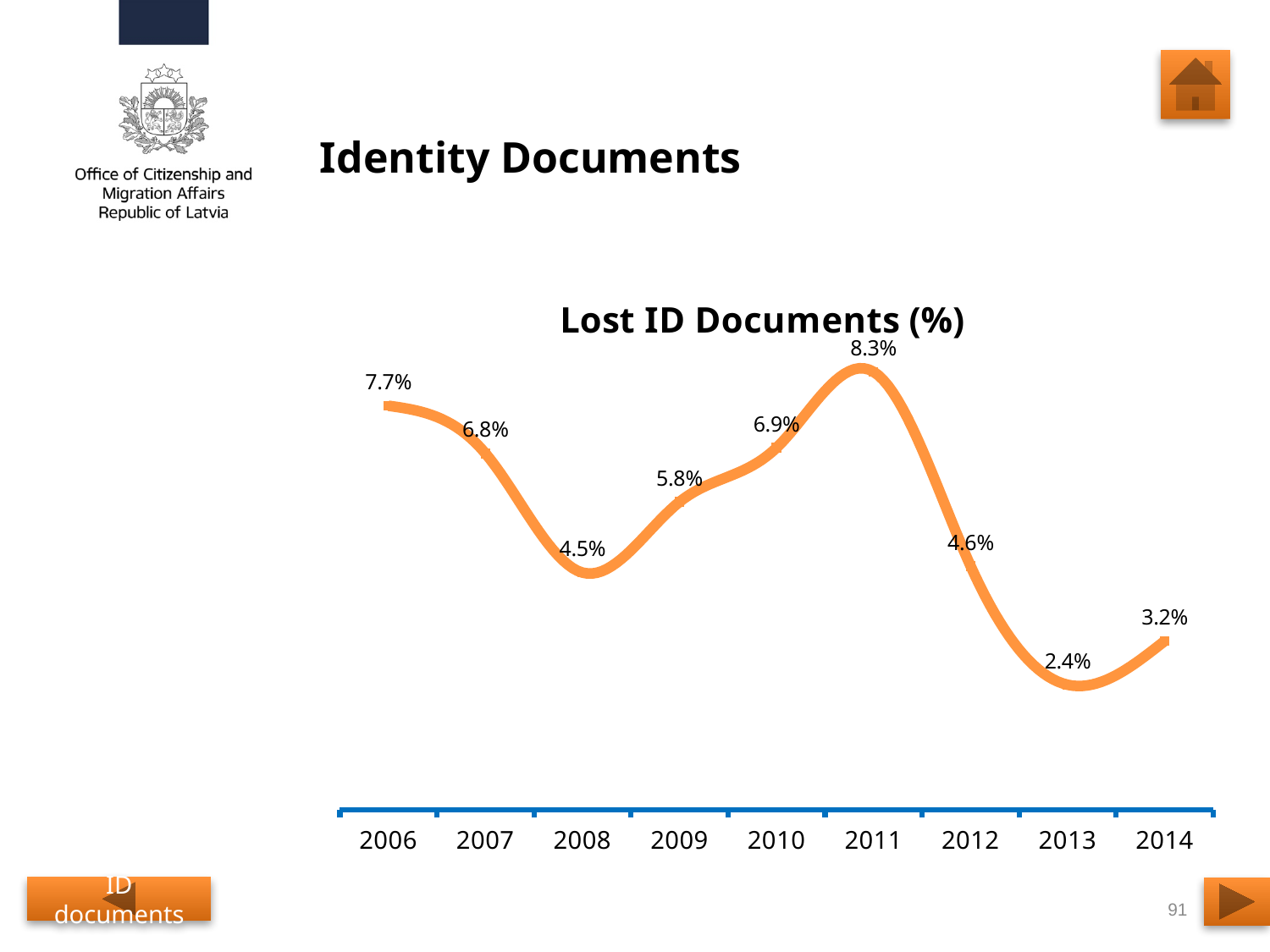
Which year has the lowest value in the Lost ID Documents (%) chart? 2013 What is the difference between the values for 2011 and 2013 in the Lost ID Documents (%) chart? 5.9% Which year has the highest value in the Lost ID Documents (%) chart? 2011 Does the value in the Lost ID Documents (%) chart rise or fall from 2011 to 2013? fall What is the value for 2011 in the Lost ID Documents (%) chart? 8.3% What kind of chart is the Lost ID Documents (%) chart? line chart What is the difference between the values for 2006 and 2007 in the Lost ID Documents (%) chart? 0.9% What is the value for 2009 in the Lost ID Documents (%) chart? 5.8% Which is larger in the Lost ID Documents (%) chart, the value for 2010 or the value for 2012? 2010 What is the value for 2013 in the Lost ID Documents (%) chart? 2.4% What is the value for 2006 in the Lost ID Documents (%) chart? 7.7% How many years are plotted in the Lost ID Documents (%) chart? 9